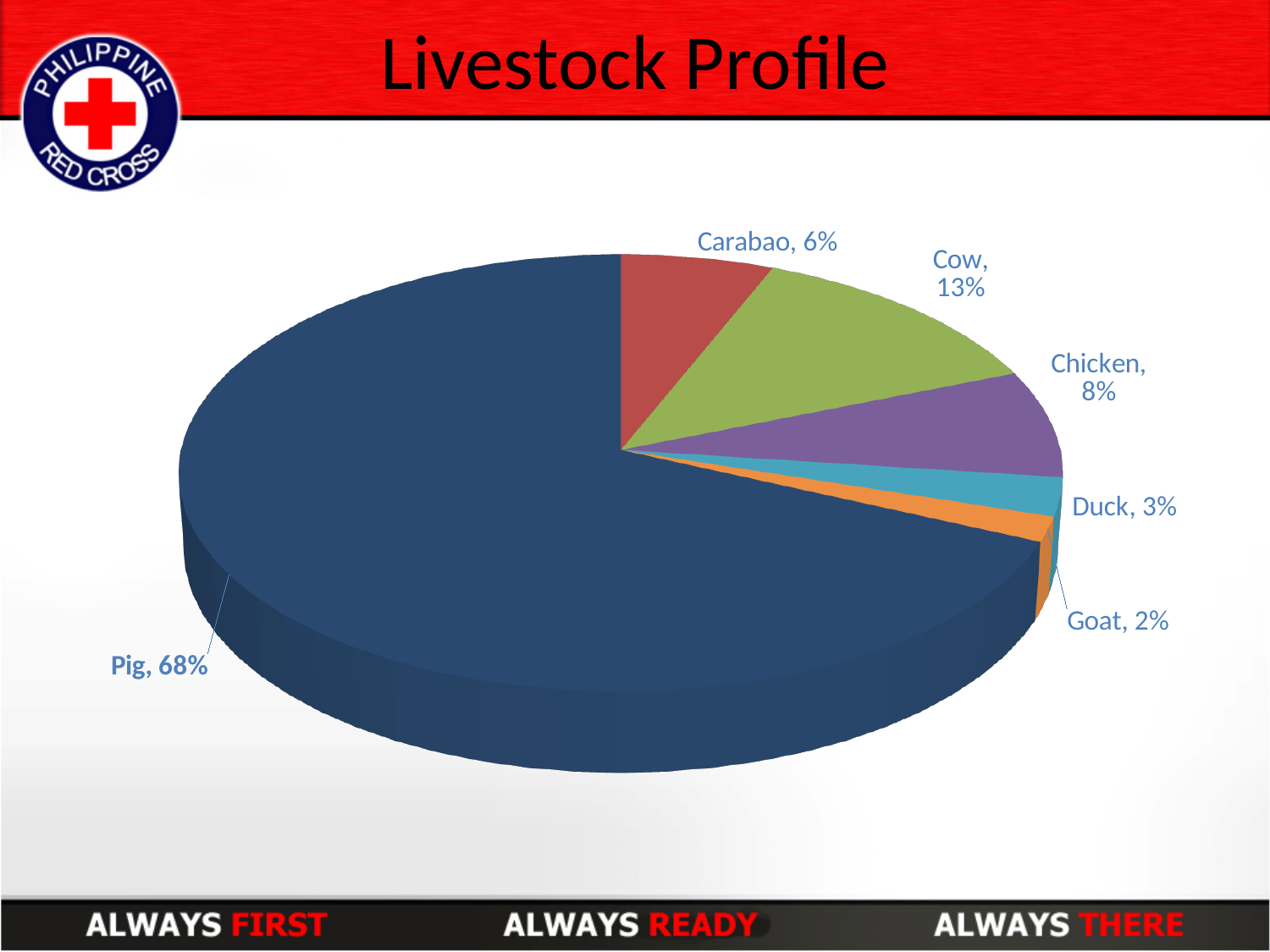
What kind of chart is shown on the slide? Pie chart What is the value for Cow? 13% What is the value for Chicken? 8% What is the value for Carabao? 6% What is the difference between the shares for Cow and Chicken? 5% What is the title of the slide containing the chart? Livestock Profile Which is larger, the share for Carabao or the share for Duck? Carabao Which category has the smallest share of the pie? Goat What is the value for Goat? 2% How many categories are shown in the pie chart? 6 Which category has the largest share of the pie? Pig What share of the pie does Pig account for? 68%